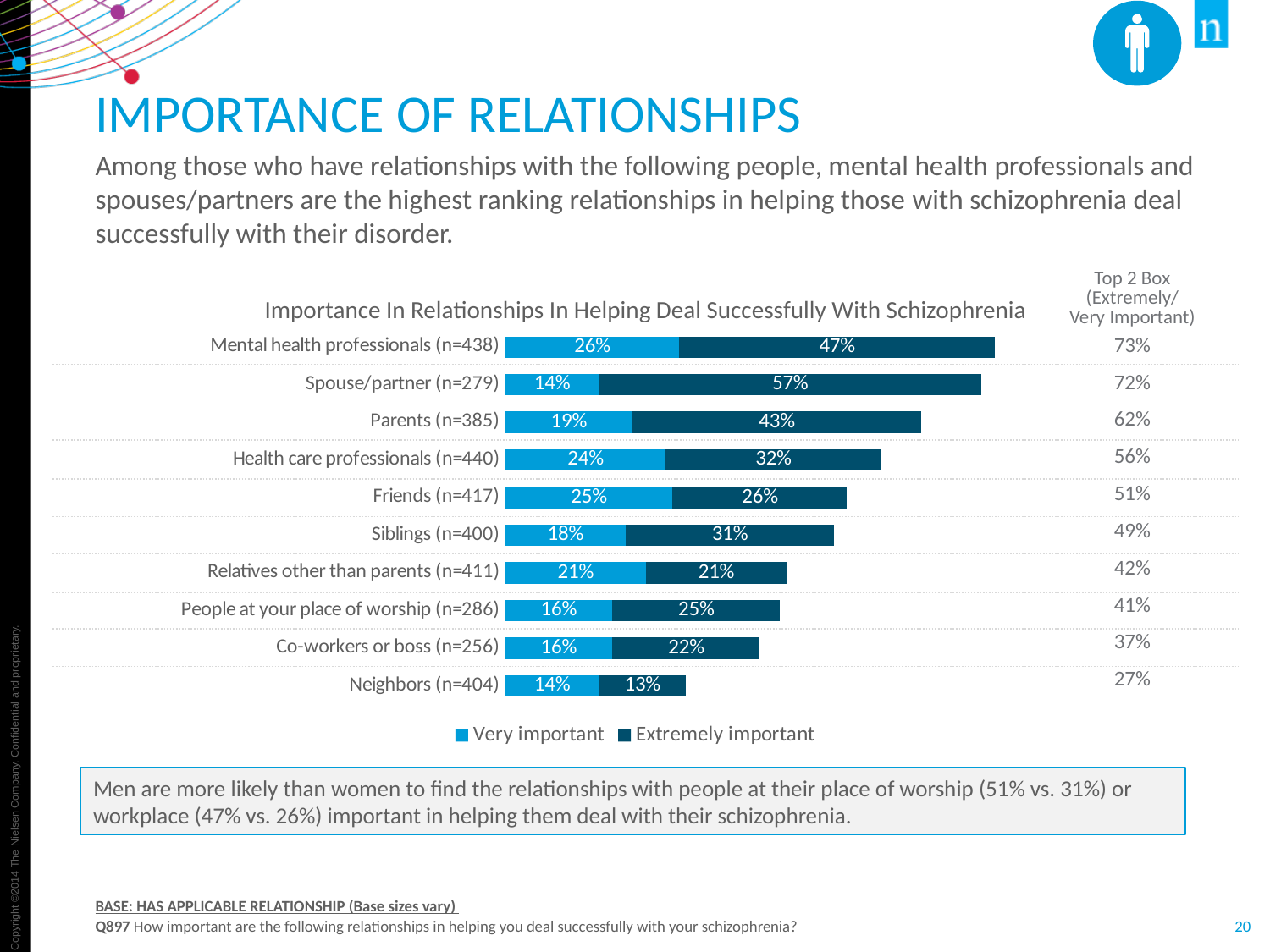
Which category has the highest 'Extremely important' value? Spouse/partner (n=279) Which is larger: the 'Very important' value for Friends (n=417) or for Siblings (n=400)? Friends (n=417) What is the difference between the 'Extremely important' values for Mental health professionals (n=438) and Parents (n=385)? 4% What is the 'Very important' value for Mental health professionals (n=438)? 26% What is the title of the chart? Importance In Relationships In Helping Deal Successfully With Schizophrenia What is the 'Extremely important' value for Neighbors (n=404)? 13% How many categories are shown in the chart? 10 How many series does the legend list? 2 What is the 'Extremely important' value for Spouse/partner (n=279)? 57% Which category has the lowest 'Extremely important' value? Neighbors (n=404) What is the total of the stacked bar for Health care professionals (n=440)? 56% What kind of chart is shown on the slide? Stacked bar chart